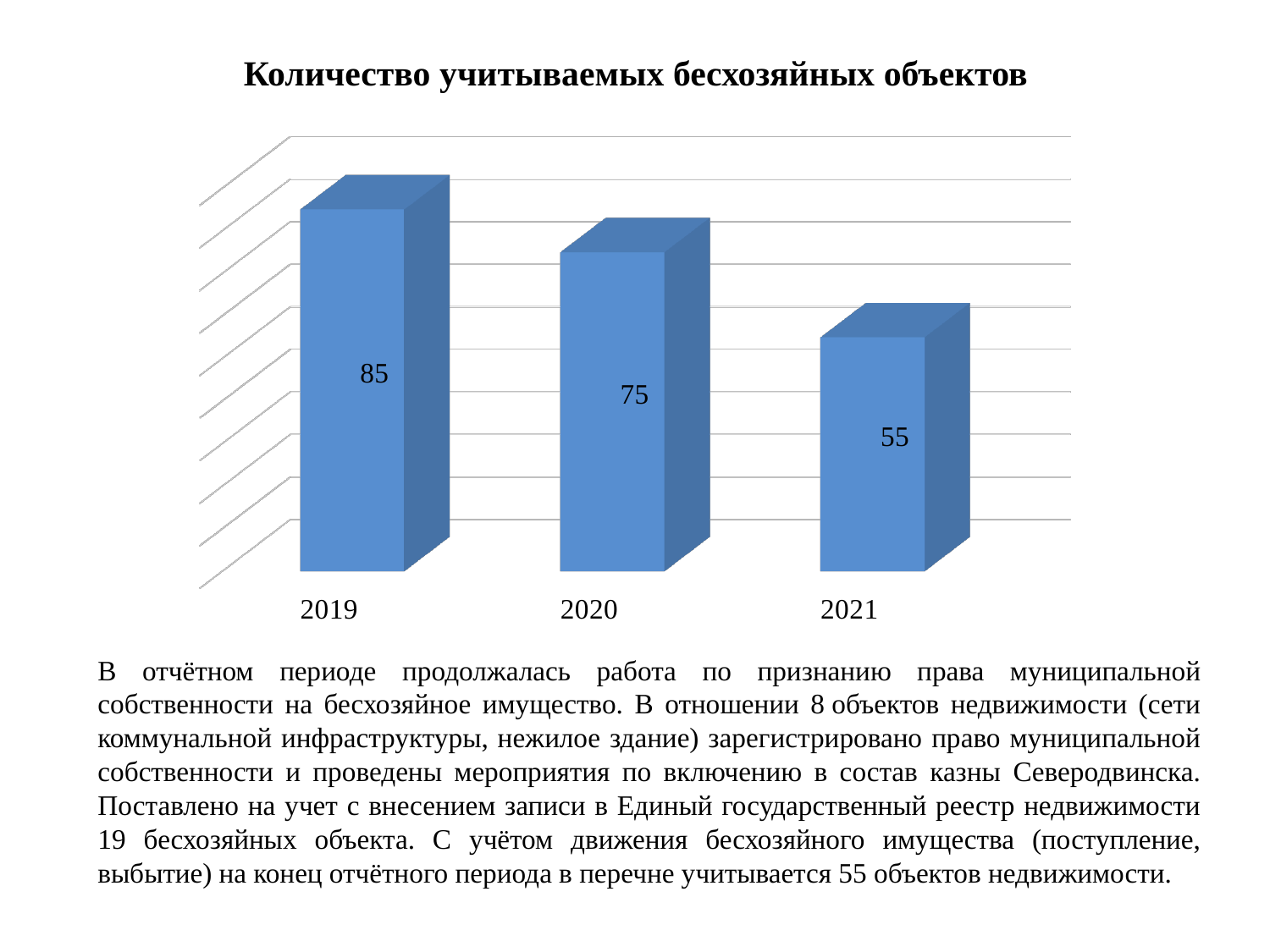
Which is larger, the value for 2020 or the value for 2021? 2020 How many years are shown on the chart? 3 What is the title of the chart? Количество учитываемых бесхозяйных объектов Do the values rise or fall from 2019 to 2021? fall What kind of chart is shown on the slide? bar chart Which year has the highest value? 2019 What is the value for 2019? 85 What is the value for 2020? 75 Which year has the lowest value? 2021 What is the difference between the values for 2019 and 2021? 30 What is the difference between the values for 2020 and 2021? 20 What is the value for 2021? 55